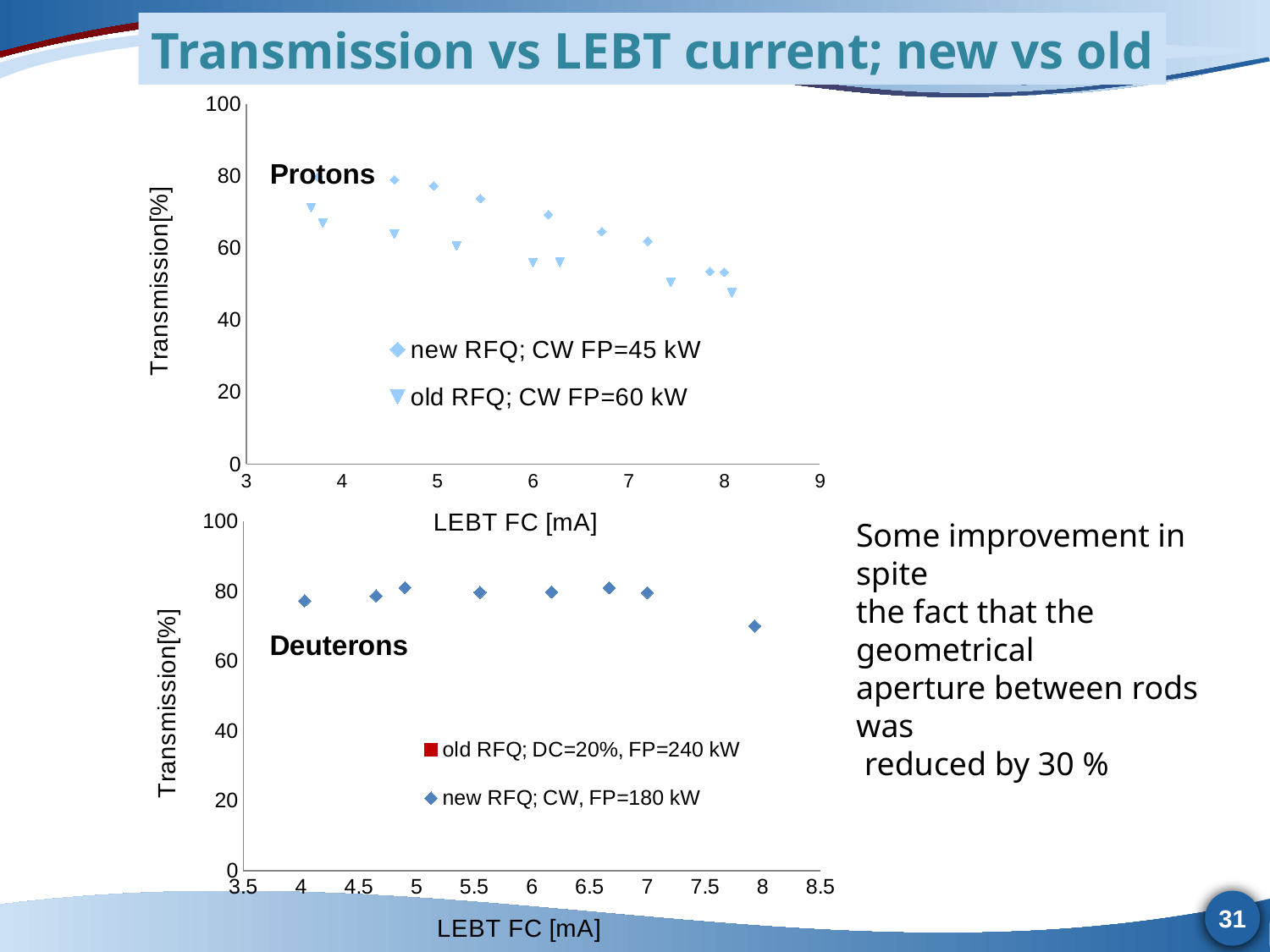
What kind of chart is the Protons chart at the top of the slide? scatter chart In the Protons chart, does the transmission for the new RFQ series rise or fall as LEBT FC current increases? fall In the Protons chart, is the transmission of the old RFQ point at about 8 mA greater or less than 60? less What kind of chart is the Deuterons chart at the bottom of the slide? scatter chart How many series does the legend of the Deuterons chart list? 2 What is the x-axis label of the Deuterons chart? LEBT FC [mA] In the Deuterons chart, is the transmission of the point at about 8 mA greater or less than 60? greater In the Protons chart, which series generally has higher transmission, new RFQ or old RFQ? new RFQ How many series does the legend of the Protons chart list? 2 What is the legend entry for the new RFQ series in the Deuterons chart? new RFQ; CW, FP=180 kW In the Protons chart, is the transmission of the new RFQ point at about 4.5 mA greater or less than 60? greater In the Protons chart, does the transmission for the old RFQ series rise or fall as LEBT FC current increases? fall